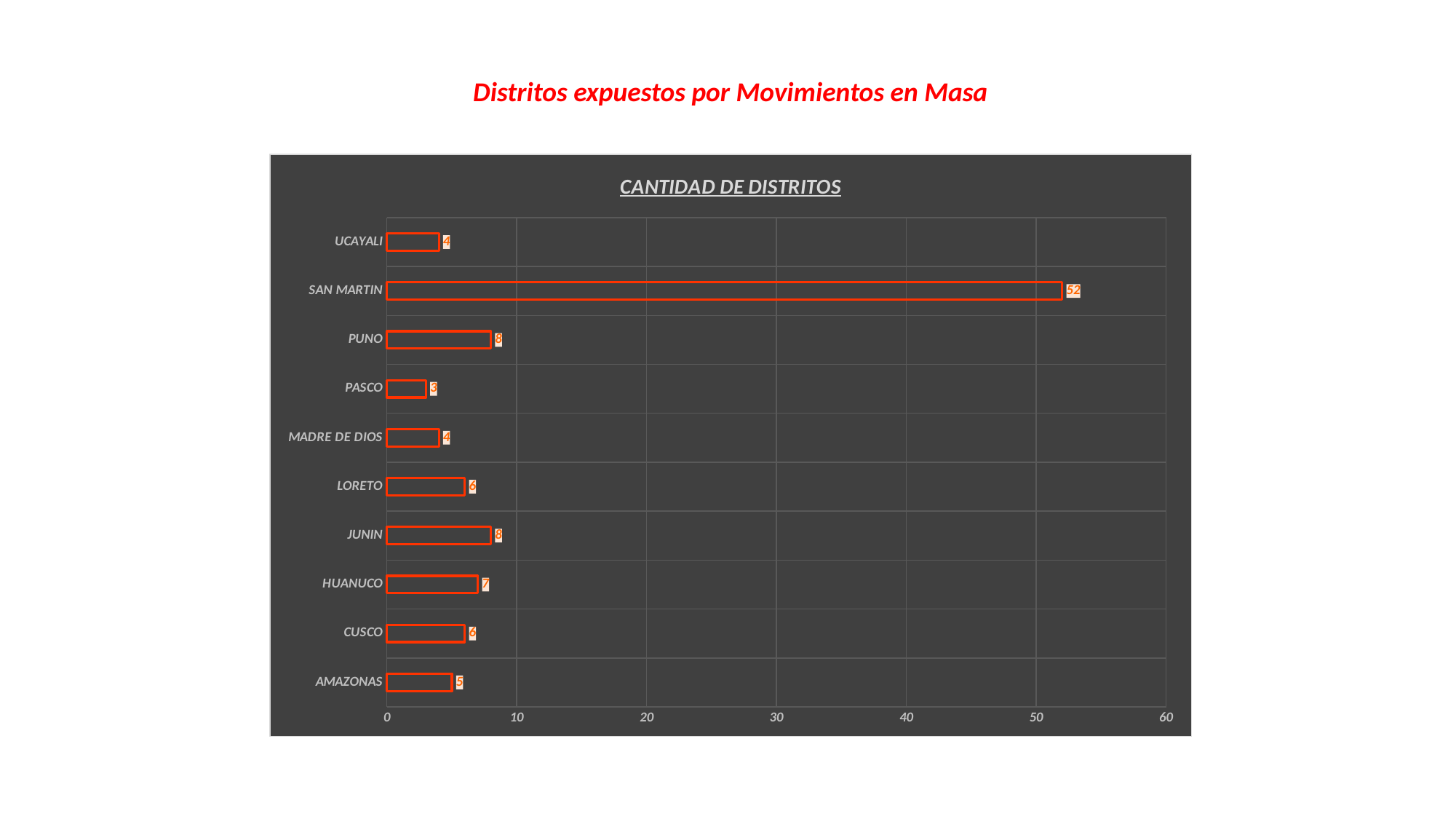
What is the value for SAN MARTIN? 52 How many categories are shown on the chart? 10 Which category has the lowest value? PASCO What is the value for PASCO? 3 What is the value for AMAZONAS? 5 What is the value for PUNO? 8 Which category has the highest value? SAN MARTIN Which is larger, the value for HUANUCO or the value for CUSCO? HUANUCO What is the difference between the values for SAN MARTIN and PUNO? 44 What kind of chart is shown on the slide? bar chart Is the value for SAN MARTIN greater or less than 50? greater What is the title of the chart? CANTIDAD DE DISTRITOS